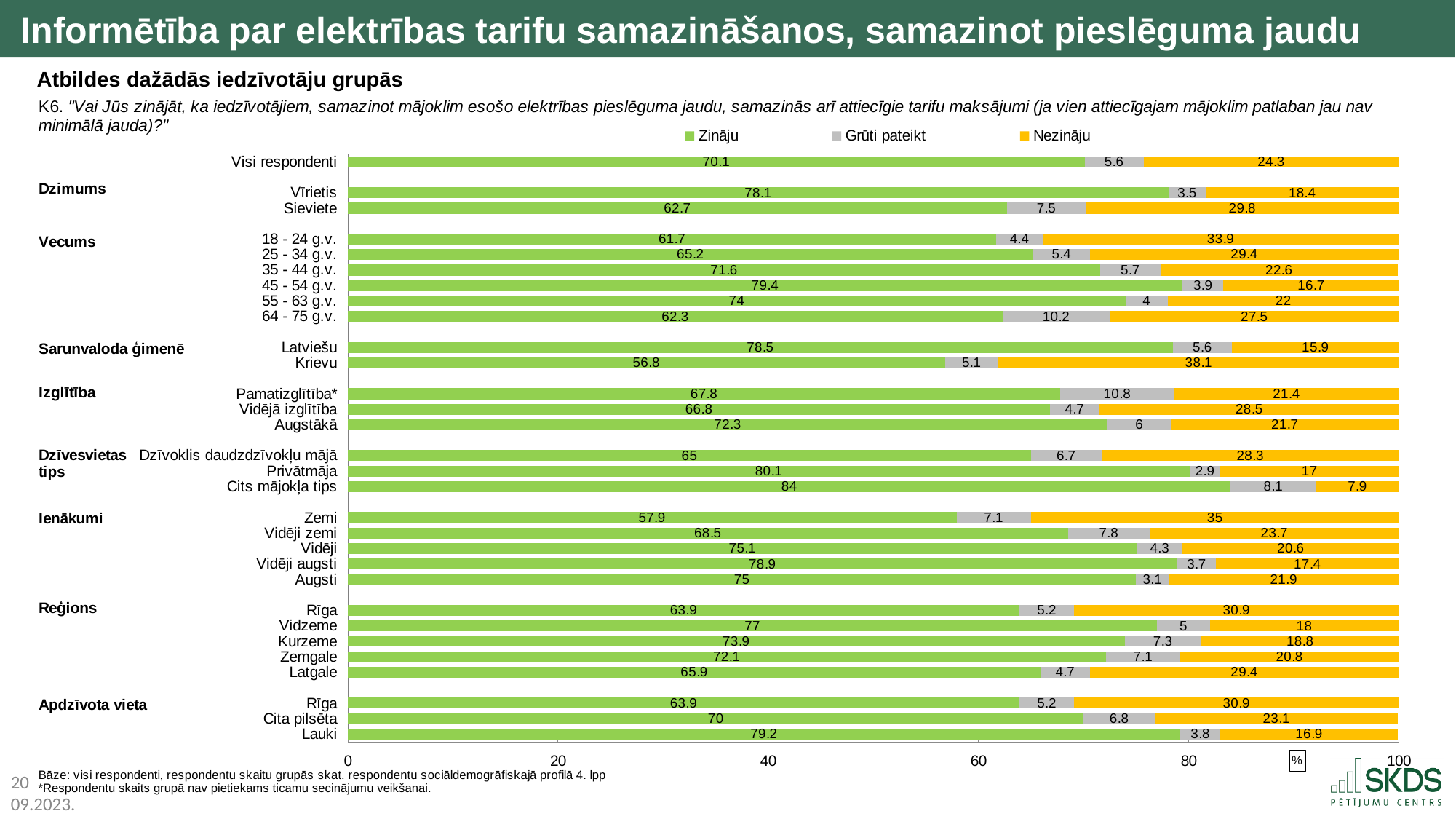
Which has a larger Nezināju value, Latviešu or Krievu? Krievu How many series does the legend list? 3 What is the Grūti pateikt value for the 64 - 75 g.v. age group? 10.2 What is the total of the stacked bar for Visi respondenti? 100 What is the Zināju value for Visi respondenti? 70.1 What is the difference between the Zināju values for Vīrietis and Sieviete? 15.4 What kind of chart is shown on the slide? Stacked bar chart Which group has the lowest Zināju value? Krievu What is the Nezināju value for the Krievu group? 38.1 What colour represents the Nezināju series? Yellow Which group has the highest Nezināju value? Krievu Which group has the highest Zināju value? Cits mājokļa tips